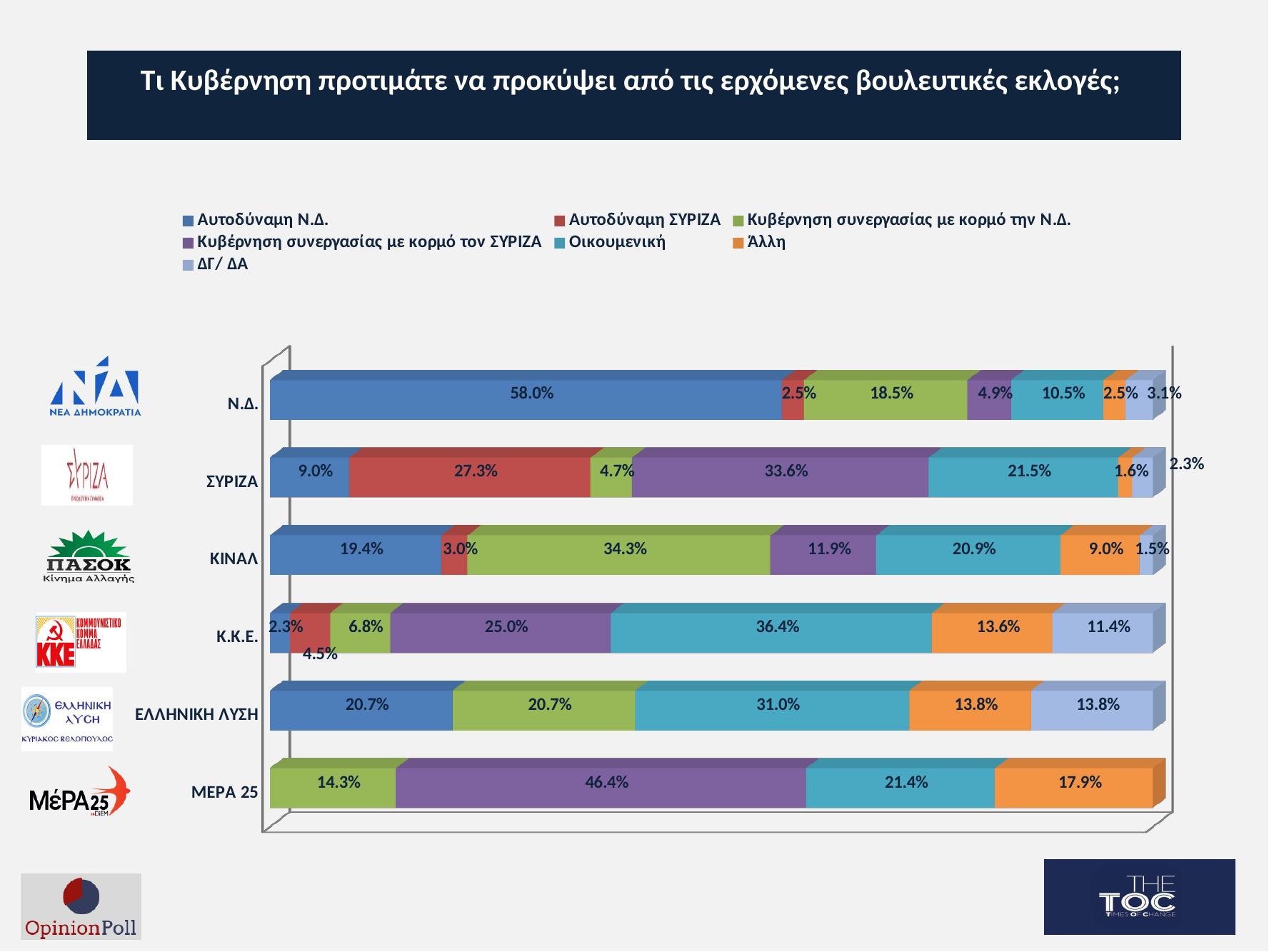
What is the value for Οικουμενική among Κ.Κ.Ε. voters? 36.4% Among ΚΙΝΑΛ voters, which is larger: Κυβέρνηση συνεργασίας με κορμό την Ν.Δ. or Οικουμενική? Κυβέρνηση συνεργασίας με κορμό την Ν.Δ. How many series does the legend list? 7 Which party's voters have the highest value for Αυτοδύναμη ΣΥΡΙΖΑ? ΣΥΡΙΖΑ Which party's voters have the highest value for Κυβέρνηση συνεργασίας με κορμό την Ν.Δ.? ΚΙΝΑΛ What is the value for Άλλη among ΕΛΛΗΝΙΚΗ ΛΥΣΗ voters? 13.8% Which party's voters have the lowest value for Οικουμενική? Ν.Δ. How many party groups (bars) are shown in the chart? 6 What kind of chart is shown on the slide? Stacked bar chart What percentage of Ν.Δ. voters prefer Αυτοδύναμη Ν.Δ.? 58.0% Among ΣΥΡΙΖΑ voters, what is the difference between Κυβέρνηση συνεργασίας με κορμό τον ΣΥΡΙΖΑ and Αυτοδύναμη ΣΥΡΙΖΑ? 6.3 percentage points What percentage of ΜΕΡΑ 25 voters prefer Κυβέρνηση συνεργασίας με κορμό τον ΣΥΡΙΖΑ? 46.4%